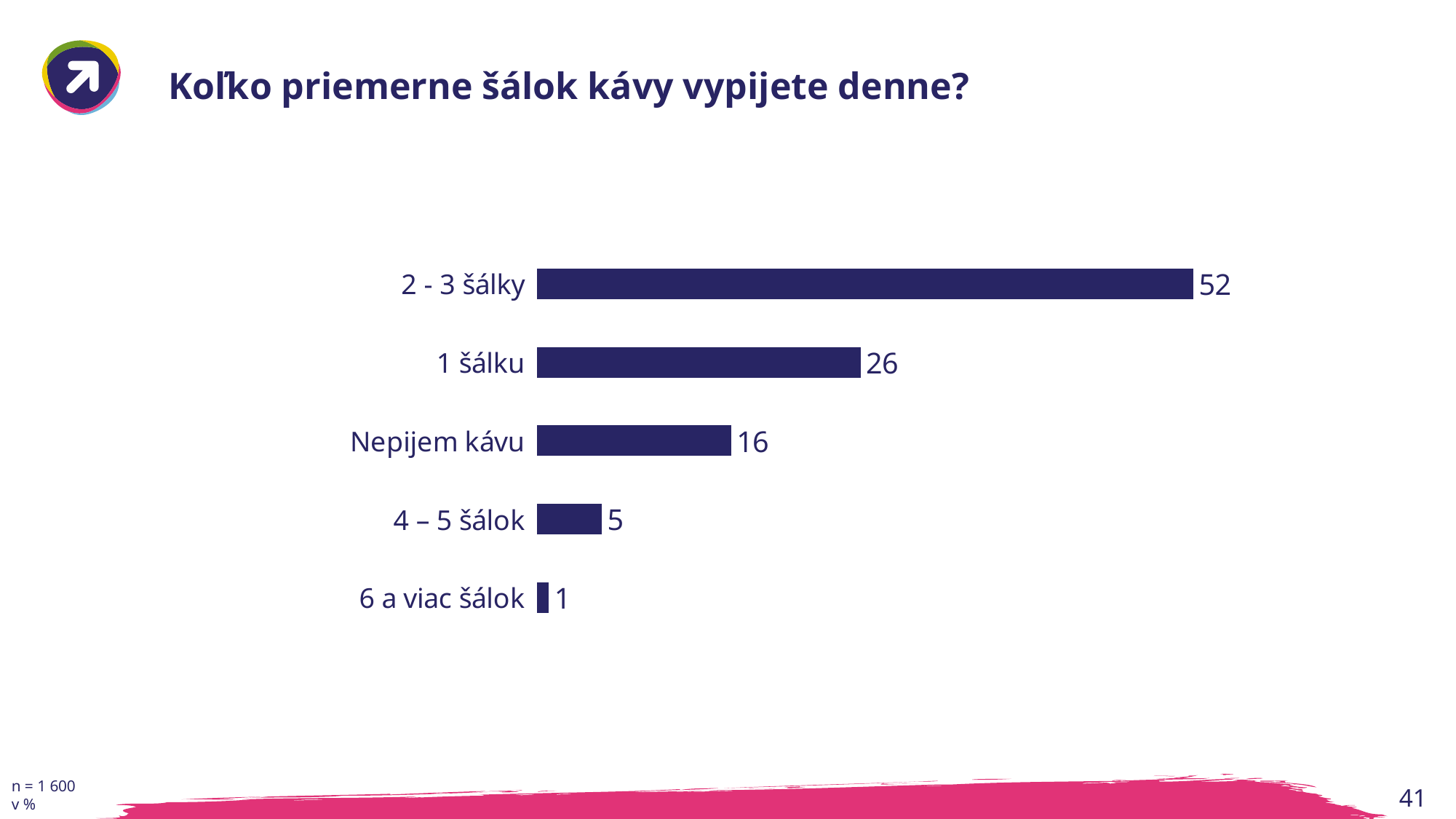
Which is larger, the value for "Nepijem kávu" or the value for "4 – 5 šálok"? Nepijem kávu What is the value for "1 šálku"? 26 What is the value for "2 - 3 šálky"? 52 What is the value for "6 a viac šálok"? 1 What kind of chart is shown on the slide? Bar chart What is the difference between the values for "2 - 3 šálky" and "1 šálku"? 26 Which category has the highest value? 2 - 3 šálky How many categories are shown in the chart? 5 What is the value for "Nepijem kávu"? 16 What is the title of the chart? Koľko priemerne šálok kávy vypijete denne? Which category has the lowest value? 6 a viac šálok What is the value for "4 – 5 šálok"? 5